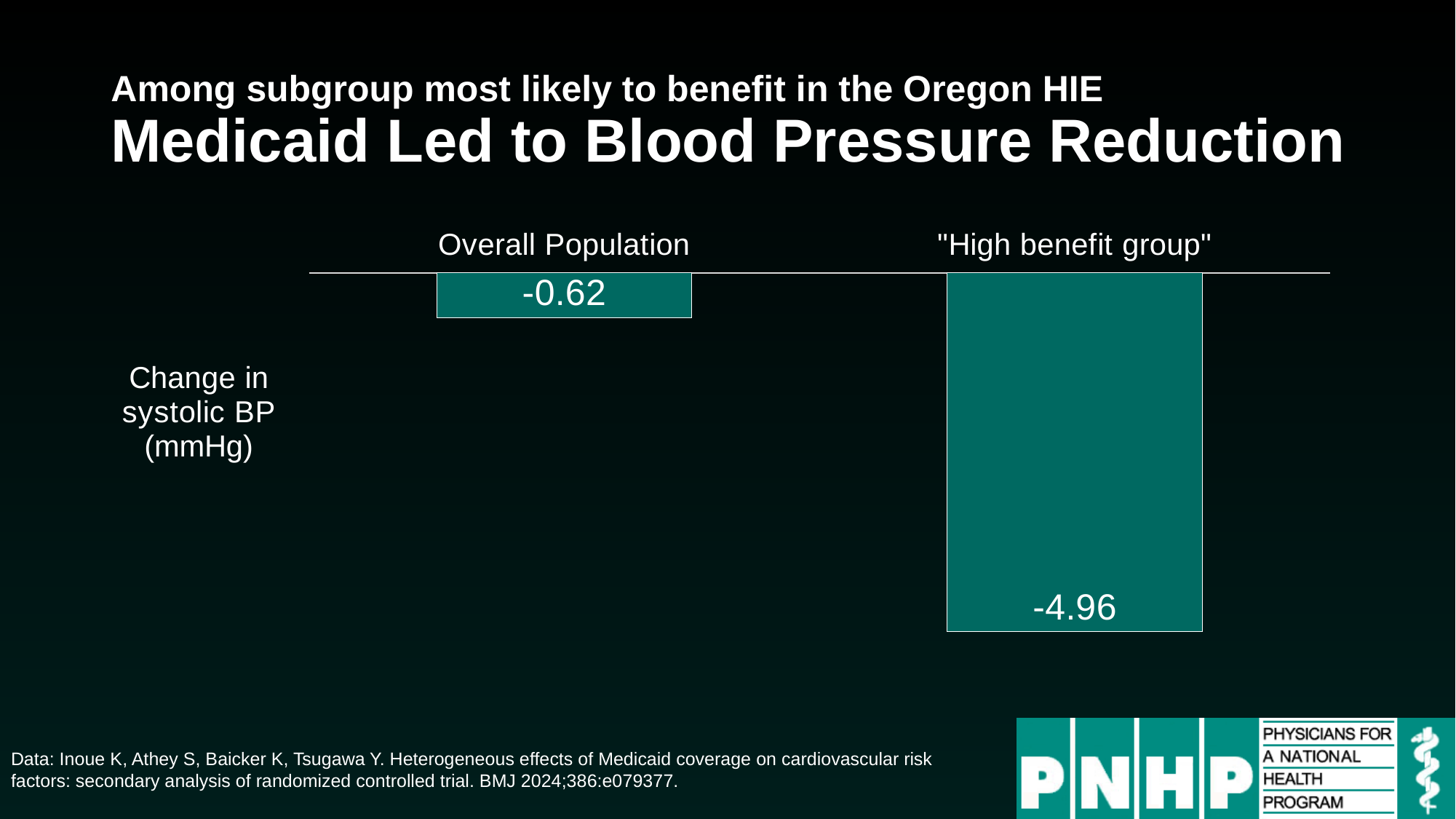
Is the reduction in systolic BP larger for the Overall Population or the "High benefit group"? "High benefit group" Are the values for both groups positive or negative? Negative How many groups are plotted in the chart? 2 What unit is the change in systolic BP measured in? mmHg What is the difference between the change in systolic BP for the "High benefit group" and the Overall Population? 4.34 What is the main title of the slide? Medicaid Led to Blood Pressure Reduction What kind of chart is shown on the slide? Bar chart Which group shows the larger reduction in systolic BP? "High benefit group" What is the change in systolic BP for the Overall Population? -0.62 What is the change in systolic BP for the "High benefit group"? -4.96 Which group shows the smaller reduction in systolic BP? Overall Population